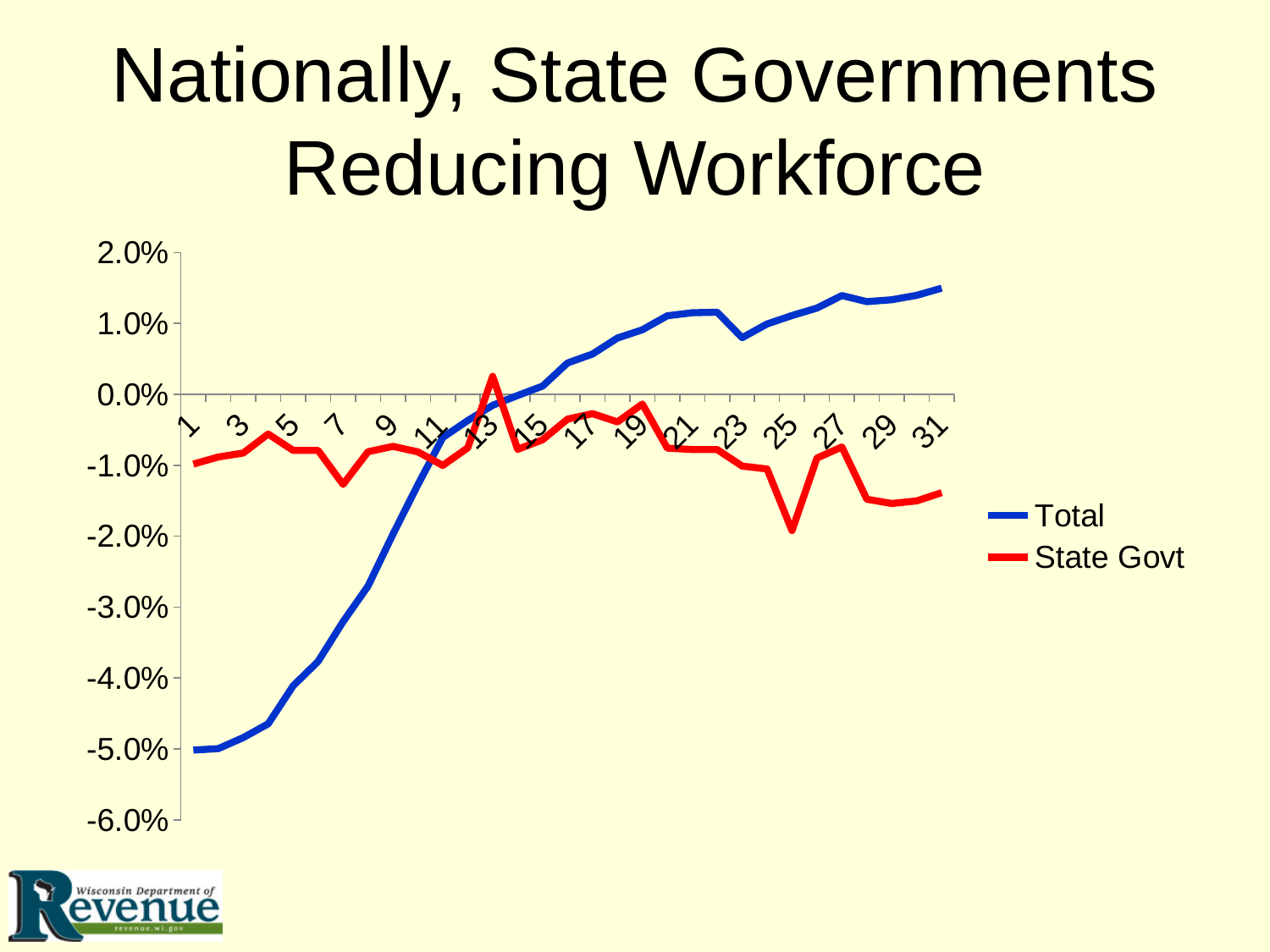
Does the Total series generally rise or fall from left to right along the x axis? rise Is the value of the Total series at point 31 greater or less than 1.0%? greater Which series is drawn in red? State Govt Is the value of the Total series at point 1 greater or less than -4.0%? less What kind of chart is shown on the slide? line chart Is the value of the State Govt series at point 25 greater or less than -1.0%? less What is the title of the slide containing the chart? Nationally, State Governments Reducing Workforce How many series does the legend list? 2